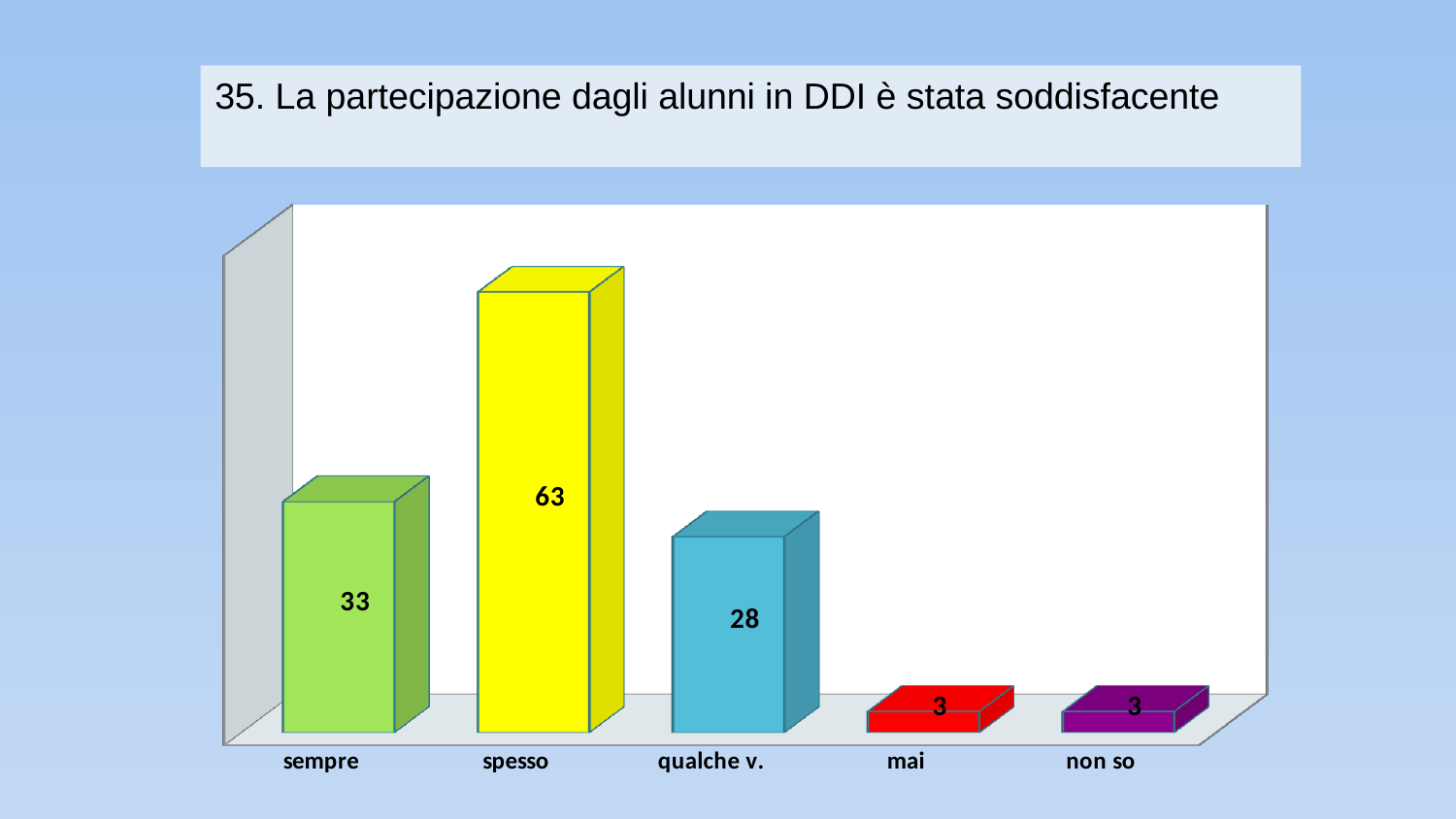
What is the difference between the values for "sempre" and "qualche v."? 5 What colour is the bar for "spesso"? yellow What is the value for "qualche v."? 28 Which is larger, the value for "sempre" or the value for "qualche v."? sempre What is the difference between the values for "spesso" and "sempre"? 30 What is the value for "mai"? 3 What is the title of the slide above the chart? 35. La partecipazione dagli alunni in DDI è stata soddisfacente Which category has the highest value? spesso What is the value for "spesso"? 63 How many categories are shown on the x axis? 5 What kind of chart is shown on the slide? bar chart What is the value for "sempre"? 33